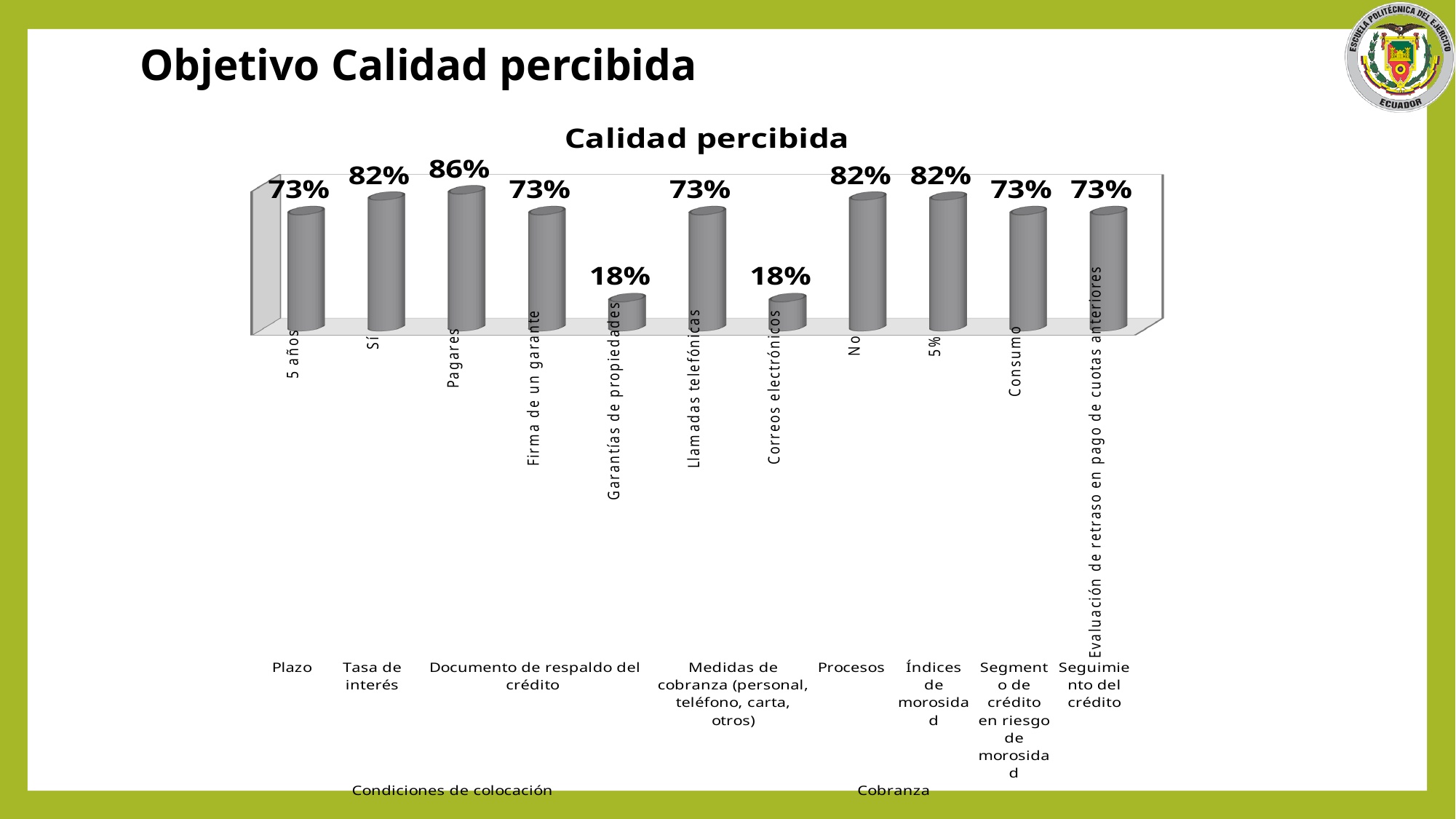
What type of chart is shown on the slide? Bar chart How many bars are plotted in the chart? 11 What is the value for Llamadas telefónicas? 73% What is the difference between the values for Sí and 5 años? 9% What is the value for Correos electrónicos? 18% Which is larger, the value for Consumo or the value for Correos electrónicos? Consumo What is the value for the category 'No' under Procesos? 82% What is the lowest value shown in the chart? 18% What is the value for Pagarés in the Calidad percibida chart? 86% Which category has the highest value in the chart? Pagarés What is the difference between the values for Pagarés and Firma de un garante? 13% What is the value for Garantías de propiedades? 18%